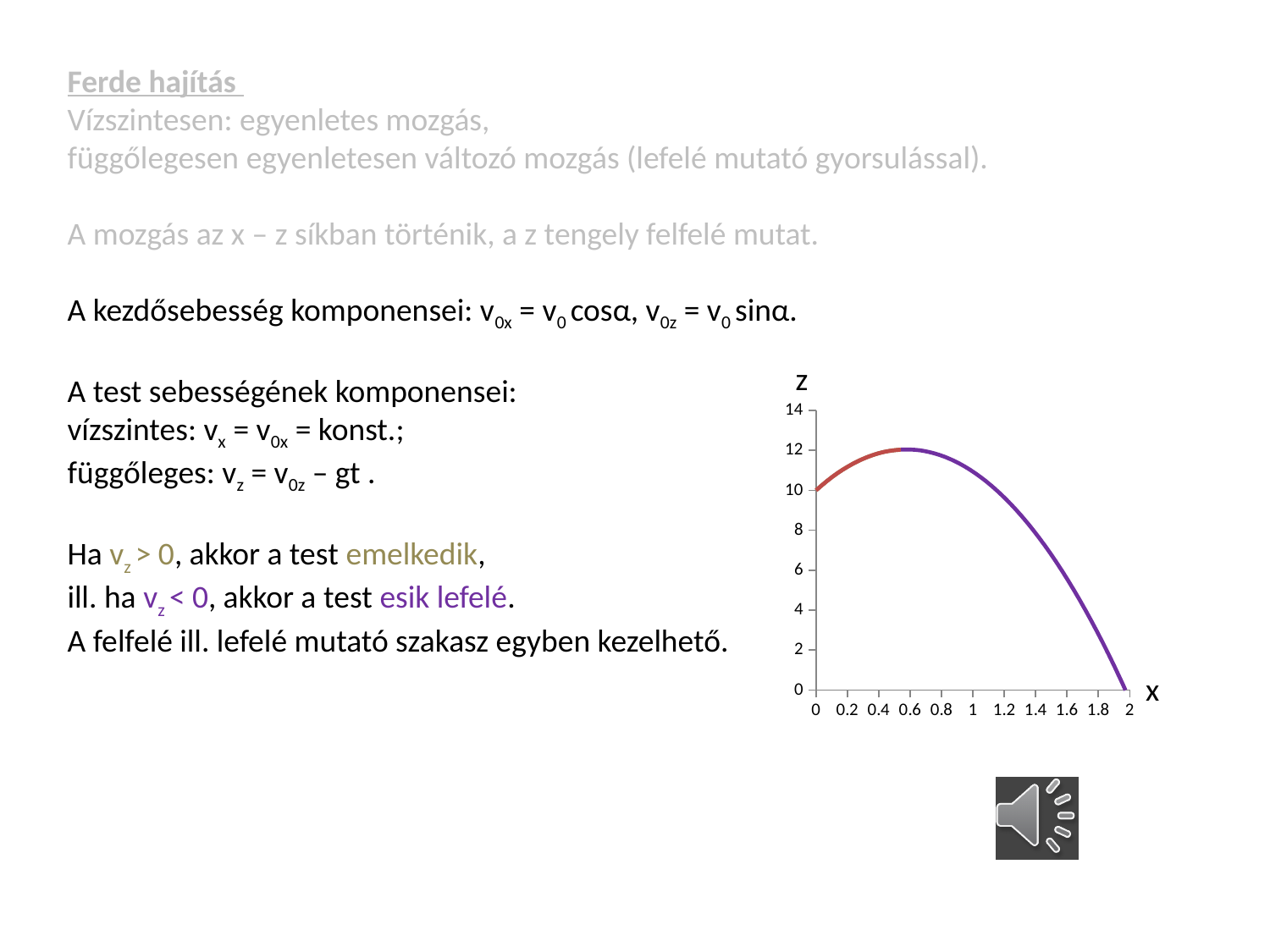
What is the value of z at x = 0 on the chart? 10 Is the value of z at x = 1 greater or less than 10? greater Which is larger, the value of z at x = 0 or at x = 2? x = 0 Is the value of z at x = 1.6 greater or less than 8? less What is the label of the vertical axis of the chart? z Does the curve rise or fall between x = 1 and x = 2? fall What kind of chart is shown on the slide? line chart What is the label of the horizontal axis of the chart? x Is the highest point of the curve greater or less than 10? greater